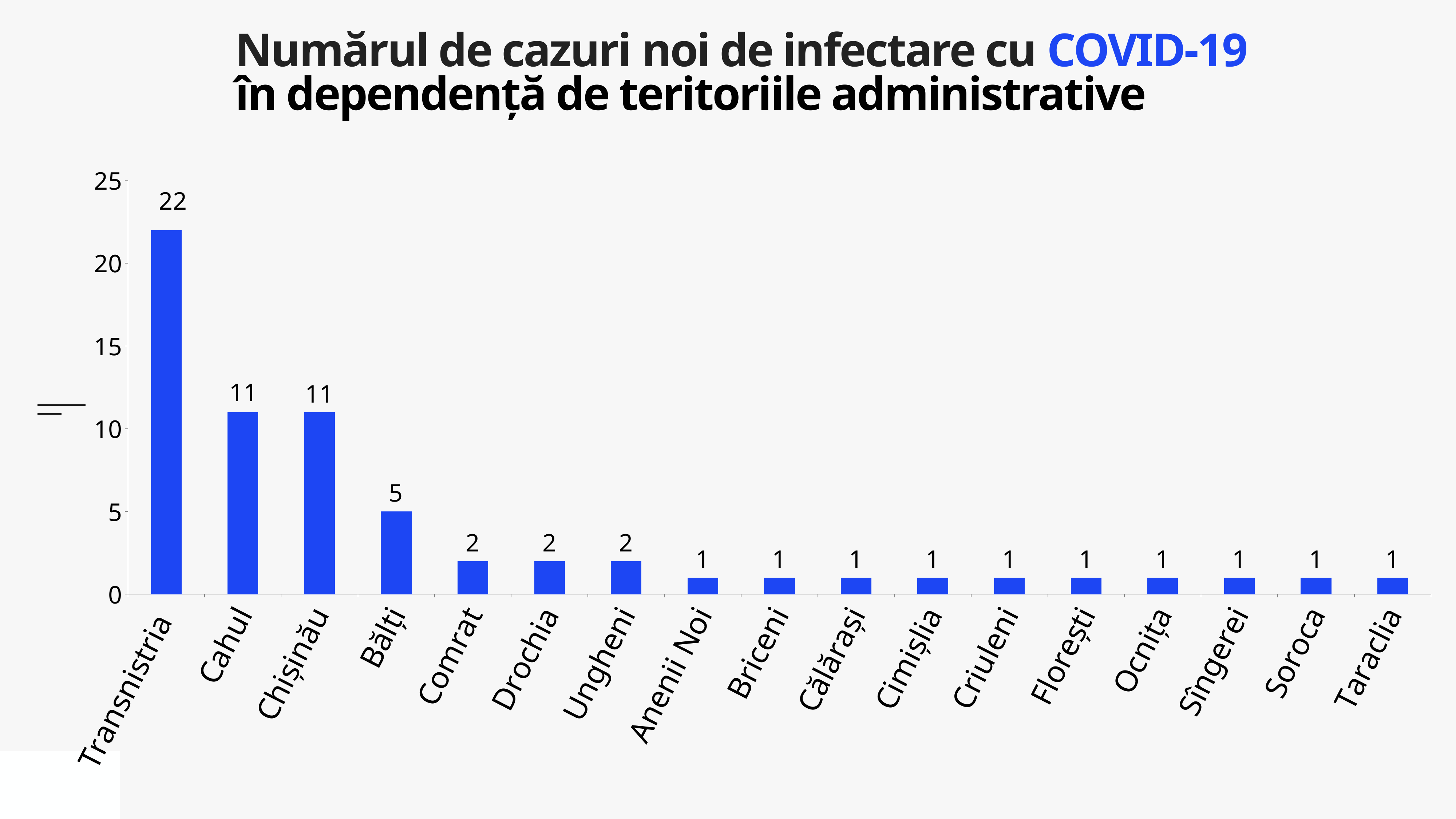
What is the difference between the values for Bălți and Comrat? 3 What is the difference between the values for Transnistria and Cahul? 11 Which is larger, the value for Chișinău or the value for Bălți? Chișinău What is the value for Ungheni? 2 What is the value for Transnistria? 22 What kind of chart is shown on the slide? bar chart Do the values rise or fall from left to right along the x axis? fall Is the value for Transnistria greater or less than 20? greater What colour are the bars in the chart? blue How many categories are shown on the x axis? 17 Which category has the highest value? Transnistria What is the value for Bălți? 5